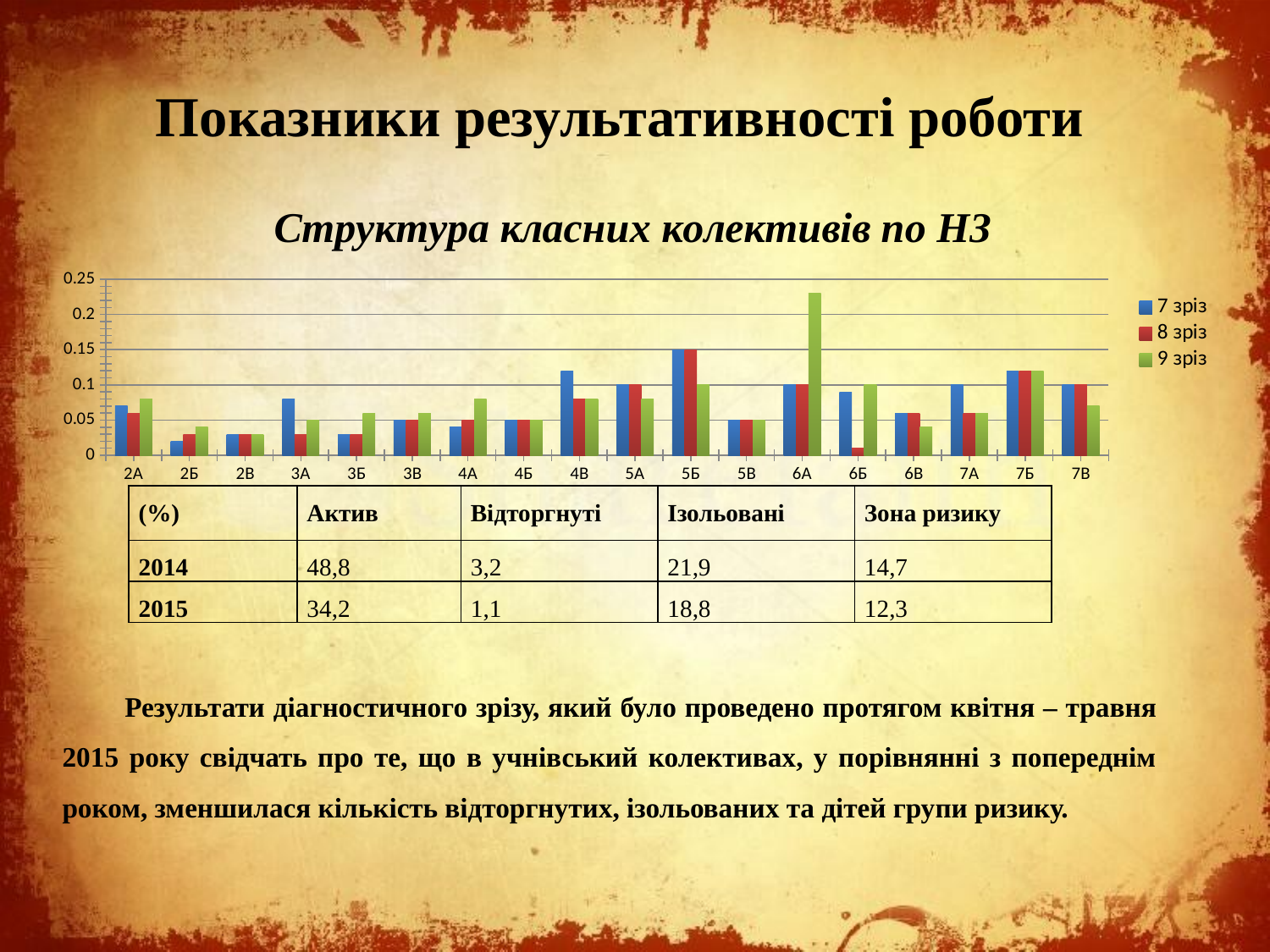
For class 6Б, which is larger: the value of 7 зріз or the value of 8 зріз? 7 зріз Is the value of 8 зріз for class 6Б greater or less than 0.05? less How many class categories are shown along the x axis of the chart? 18 What is the title of the chart? Структура класних колективів по НЗ Is the value of 7 зріз for class 4В greater or less than 0.1? greater How many series does the chart legend list? 3 What kind of chart is shown on the slide? bar chart Which class has the highest bar in the chart? 6А For class 6А, which series has the highest bar? 9 зріз What colour represents the series 9 зріз in the chart? green Is the value of 7 зріз for class 2Б greater or less than 0.05? less